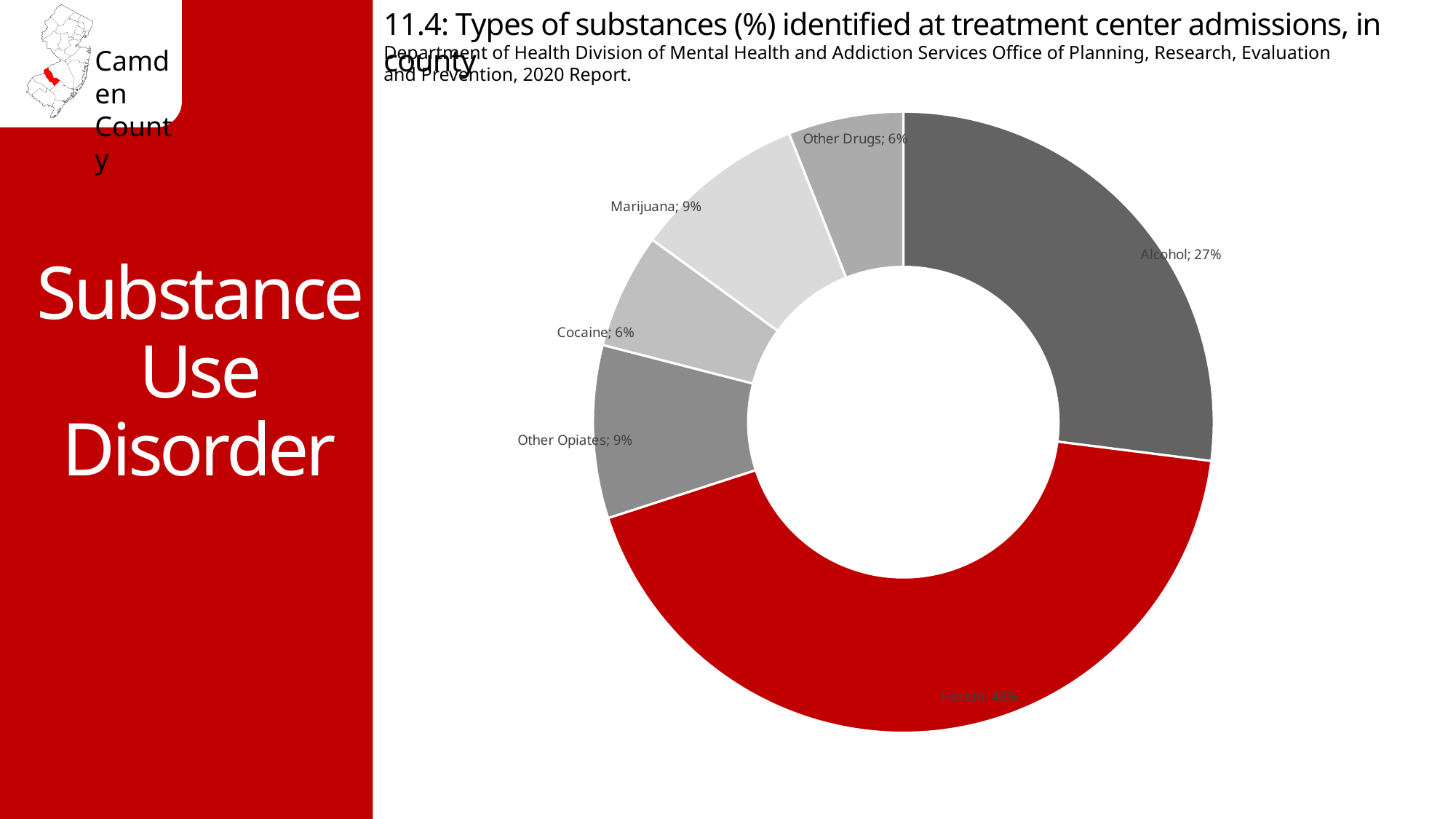
What percentage is shown for Cocaine? 6% What percentage is shown for Other Opiates? 9% Which slice of the chart is coloured red? Heroin What percentage is shown for Other Drugs? 6% What kind of chart is shown on the slide? pie (doughnut) chart How many substance categories are shown in the chart? 6 What is the difference in percentage points between Alcohol and Marijuana? 18 Which is larger, the share for Other Opiates or the share for Cocaine? Other Opiates Which substance has the largest share of the chart? Heroin What percentage is shown for Marijuana? 9% What percentage of treatment center admissions identified Alcohol? 27% Which substance has the largest share among the grey slices? Alcohol